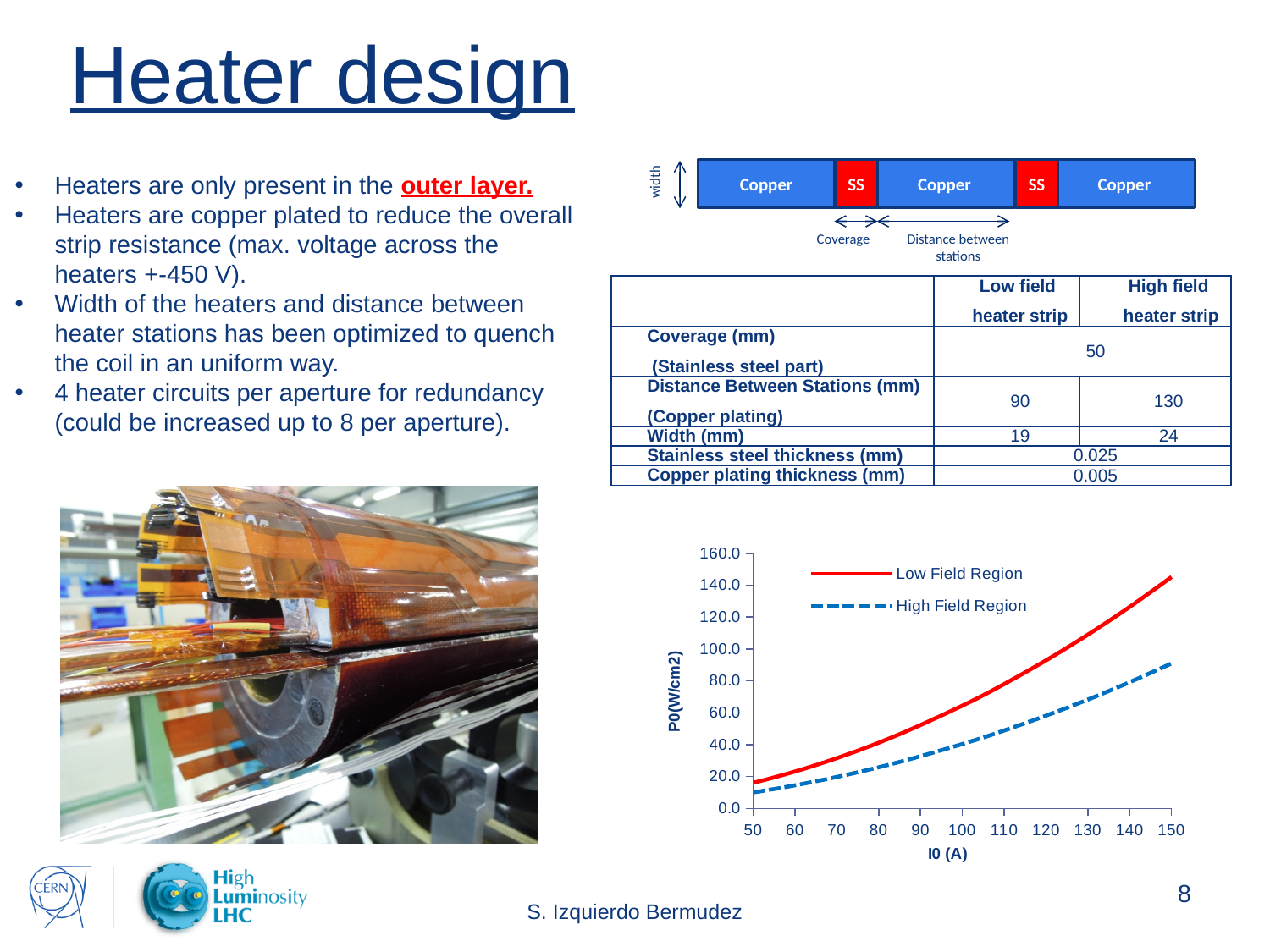
Is the P0 value for the Low Field Region at I0 = 100 A greater or less than 40.0? greater What are the two series named in the chart's legend? Low Field Region and High Field Region Is the P0 value for the Low Field Region at I0 = 150 A greater or less than 120.0? greater Do the values of the Low Field Region series rise or fall as I0 increases from 50 to 150? rise What kind of chart is shown on the slide? line chart Is the P0 value for the High Field Region at I0 = 150 A greater or less than 100.0? less How many series does the chart's legend list? 2 What is the label of the chart's x axis? I0 (A) At I0 = 150 A, which series has the larger P0 value, Low Field Region or High Field Region? Low Field Region Do the values of the High Field Region series rise or fall as I0 increases along the x axis? rise